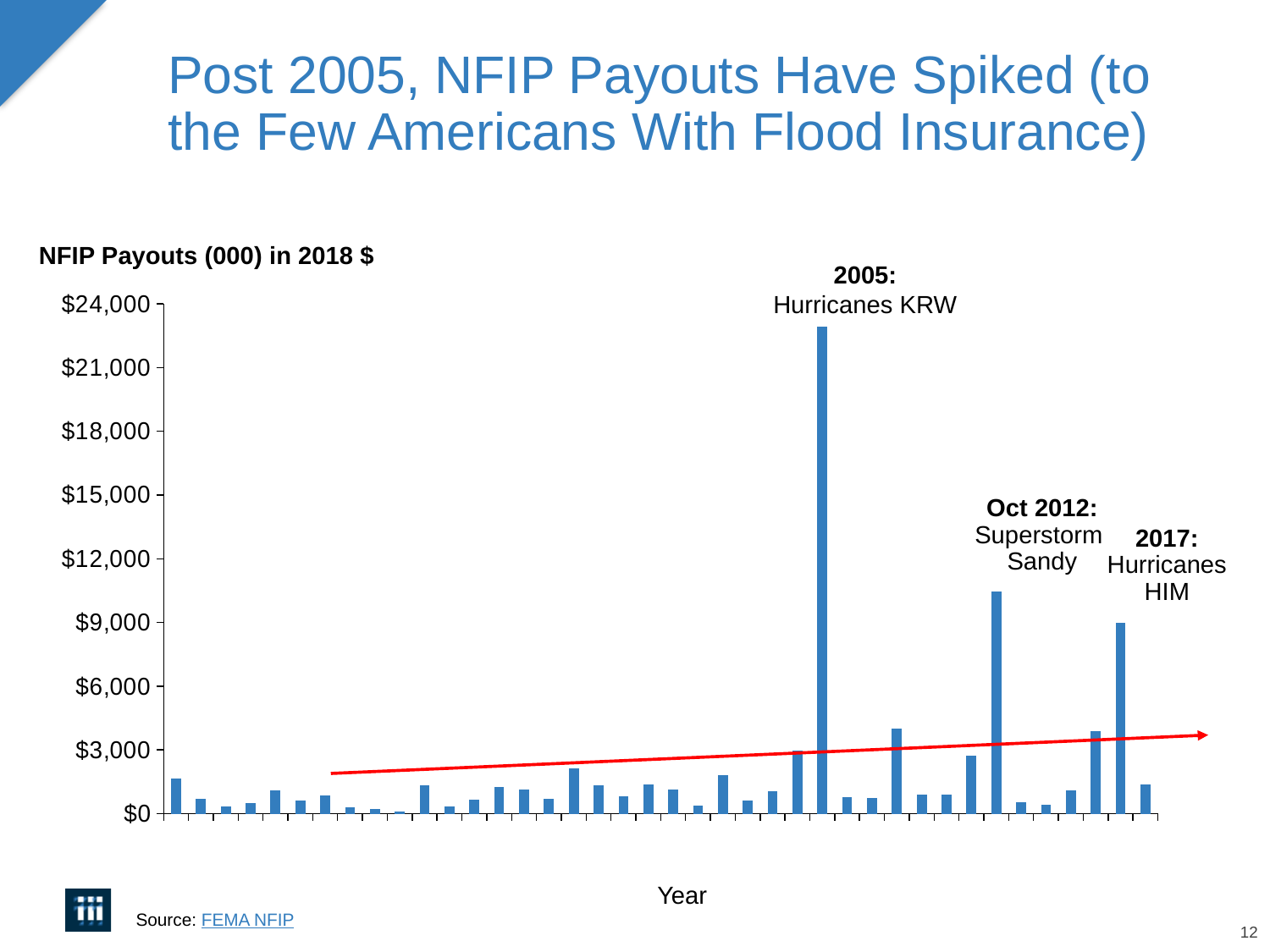
What kind of chart is shown on the slide? bar chart Which annotated event corresponds to the highest bar in the chart? 2005: Hurricanes KRW Is the value for the 2017 (Hurricanes HIM) bar greater or less than $6,000? greater Is the value for the 2017 (Hurricanes HIM) bar greater or less than $12,000? less What is the label on the x axis of the chart? Year Which is larger, the payout for 2005 (Hurricanes KRW) or for Oct 2012 (Superstorm Sandy)? 2005 (Hurricanes KRW) What is the title of the chart? NFIP Payouts (000) in 2018 $ Is the value for the Oct 2012 (Superstorm Sandy) bar greater or less than $9,000? greater Which is larger, the payout for Oct 2012 (Superstorm Sandy) or for 2017 (Hurricanes HIM)? Oct 2012 (Superstorm Sandy) According to the red trend line, do NFIP payouts generally rise or fall over the years shown? rise